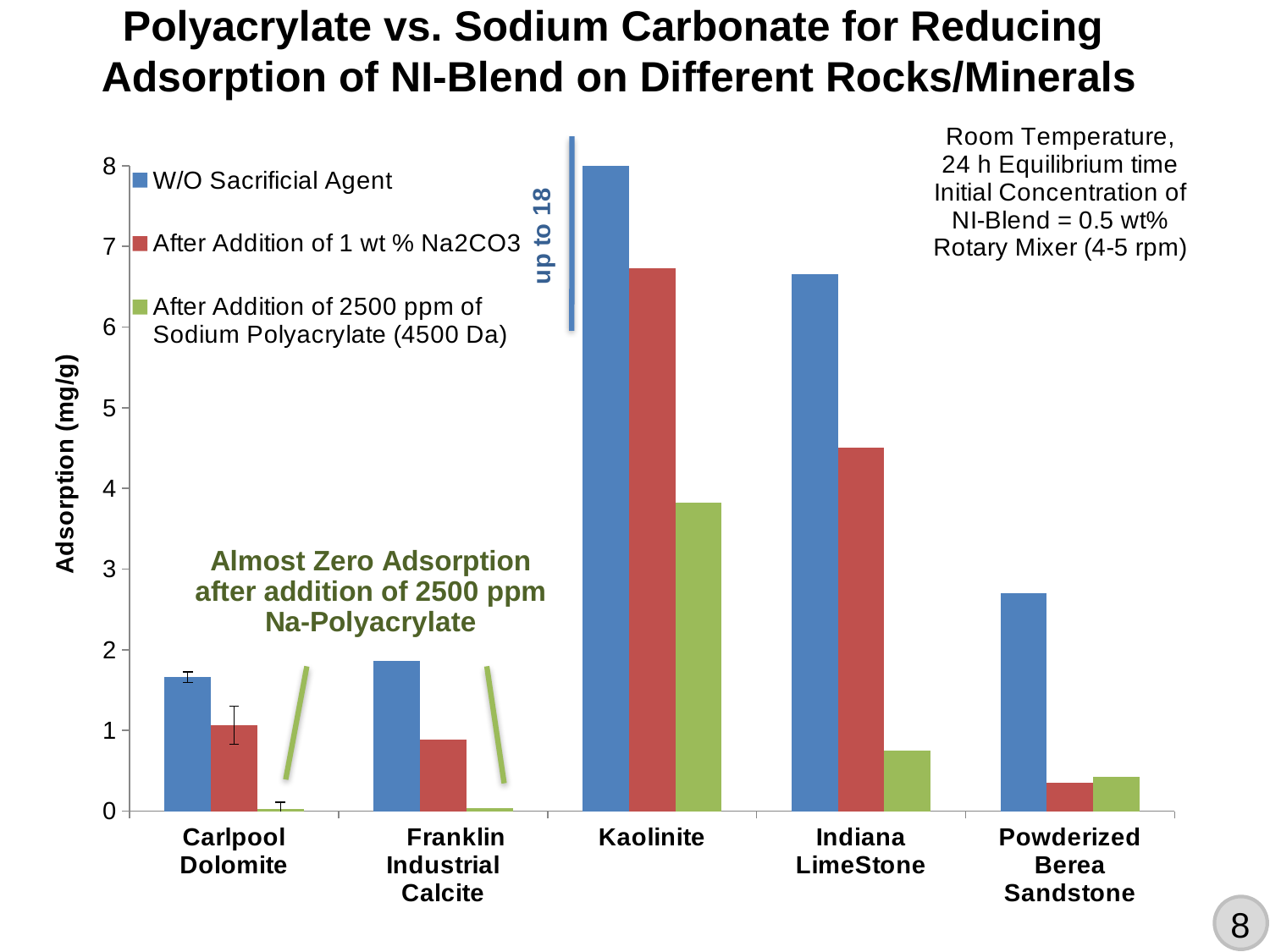
Is the adsorption for Indiana LimeStone without sacrificial agent greater or less than 6? greater Which rock/mineral has the highest adsorption without sacrificial agent? Kaolinite How many series does the legend list? 3 Which is larger: the adsorption after addition of 1 wt % Na2CO3 for Kaolinite or for Indiana LimeStone? Kaolinite Is the adsorption for Powderized Berea Sandstone without sacrificial agent greater or less than 2? greater Which rock/mineral has the lowest adsorption after addition of 1 wt % Na2CO3? Powderized Berea Sandstone What is the title of the y axis? Adsorption (mg/g) Which rock/mineral has the highest adsorption after addition of 2500 ppm of Sodium Polyacrylate? Kaolinite Is the adsorption for Carlpool Dolomite without sacrificial agent greater or less than 2? less What kind of chart is shown on the slide? bar chart How many rocks/minerals are shown on the x axis? 5